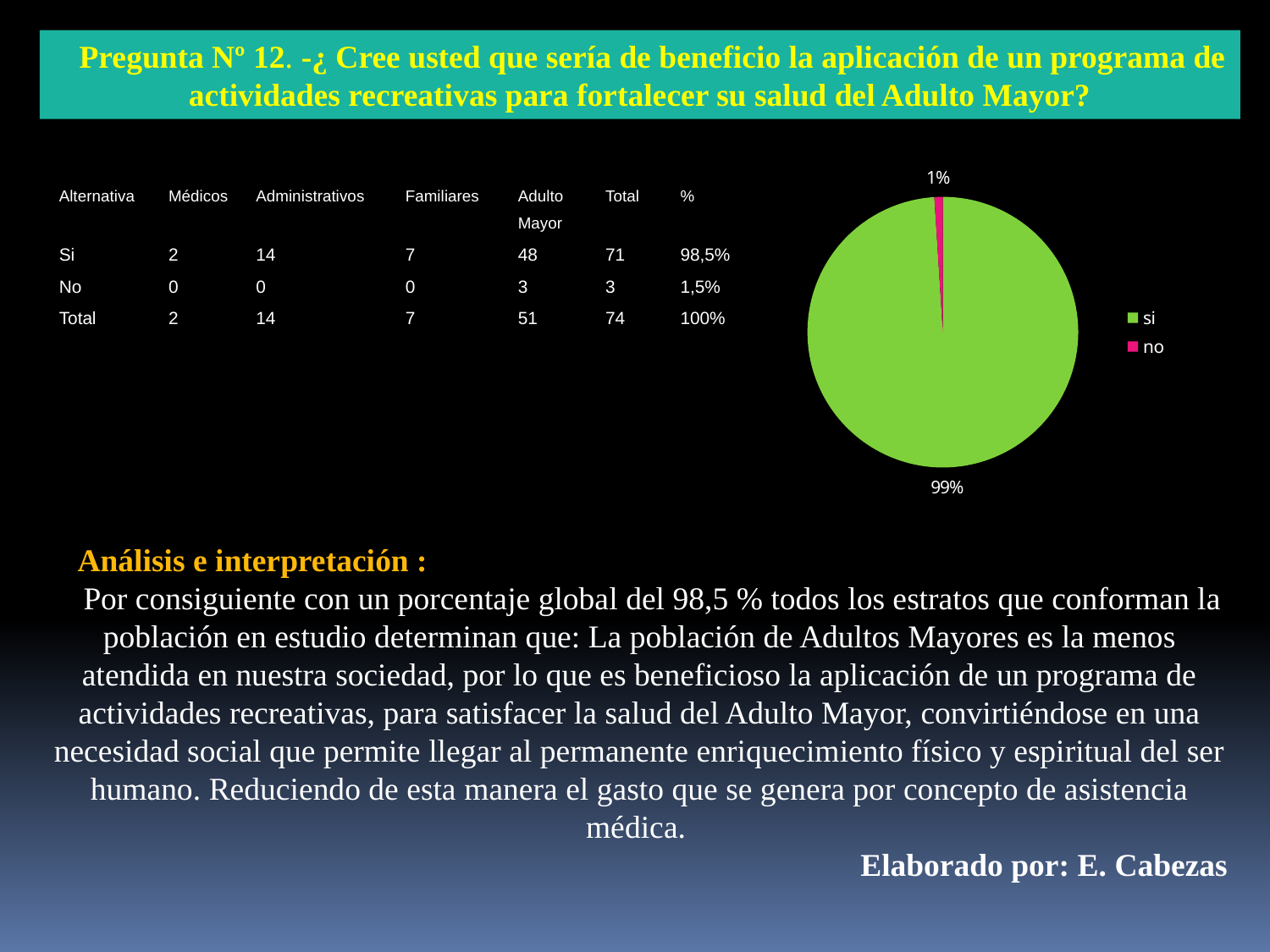
How many slices does the pie chart have? 2 What is the difference in percentage points between the 'si' and 'no' slices of the pie chart? 98% Which is larger in the pie chart, the 'si' slice or the 'no' slice? si How many entries does the legend of the pie chart list? 2 What kind of chart is shown on the slide? pie chart What percentage does the 'si' slice of the pie chart show? 99% What colour is the 'si' slice in the pie chart? green What colour is the 'no' slice in the pie chart? pink What percentage does the 'no' slice of the pie chart show? 1% Which slice of the pie chart is the smallest? no Which slice of the pie chart is the largest? si